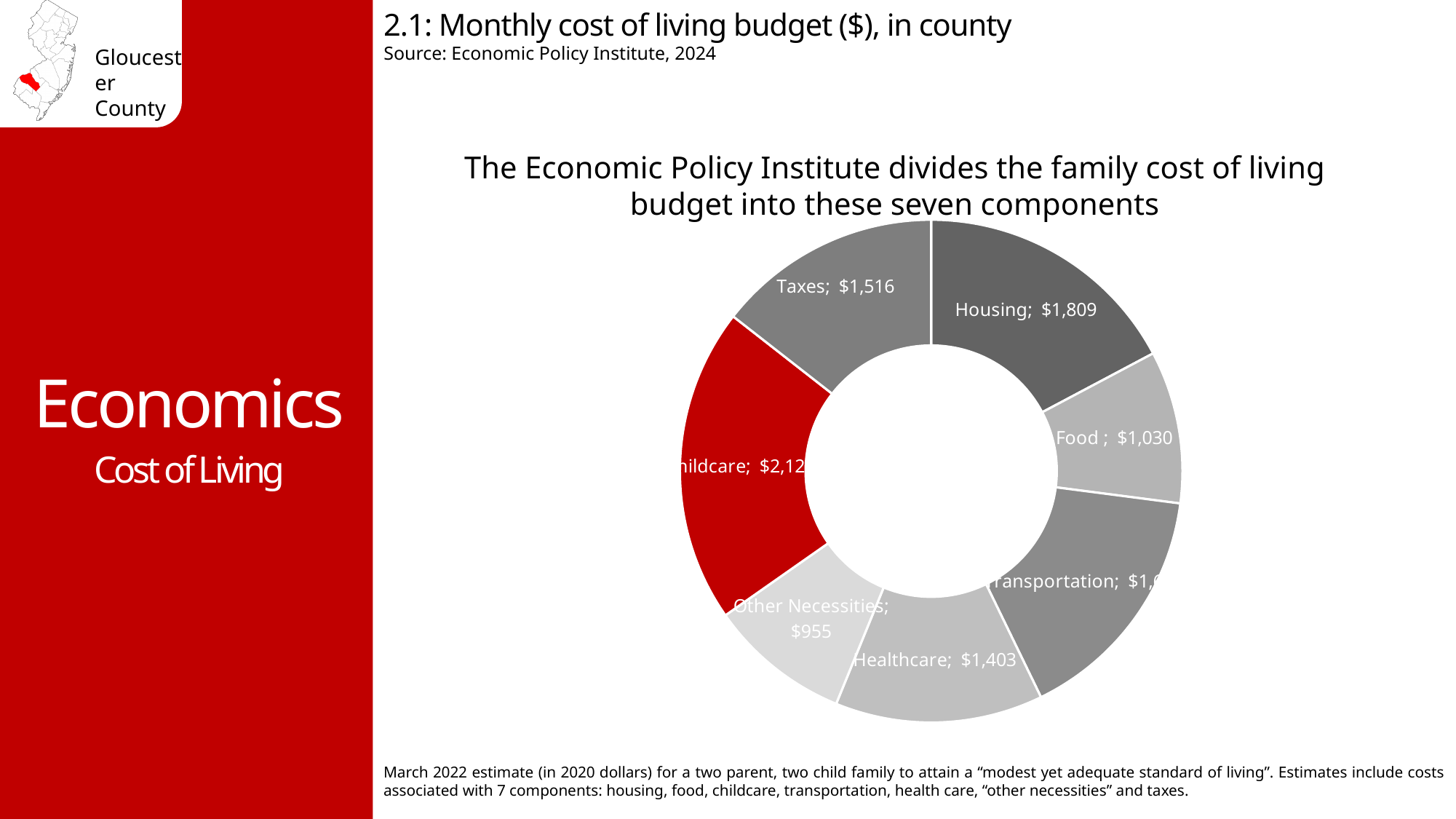
What is the monthly cost for Healthcare? $1,403 What kind of chart is shown on the slide? Doughnut chart What is the monthly cost for Taxes? $1,516 What is the difference between the Housing and Taxes monthly costs? $293 How many components are shown in the chart? 7 What is the monthly cost for Housing? $1,809 What is the difference between the Healthcare and Food monthly costs? $373 Which is larger, the monthly cost for Housing or for Taxes? Housing Which component has the smallest monthly cost? Other Necessities What is the monthly cost for Food? $1,030 What is the monthly cost for Other Necessities? $955 Which component has the largest monthly cost? Childcare